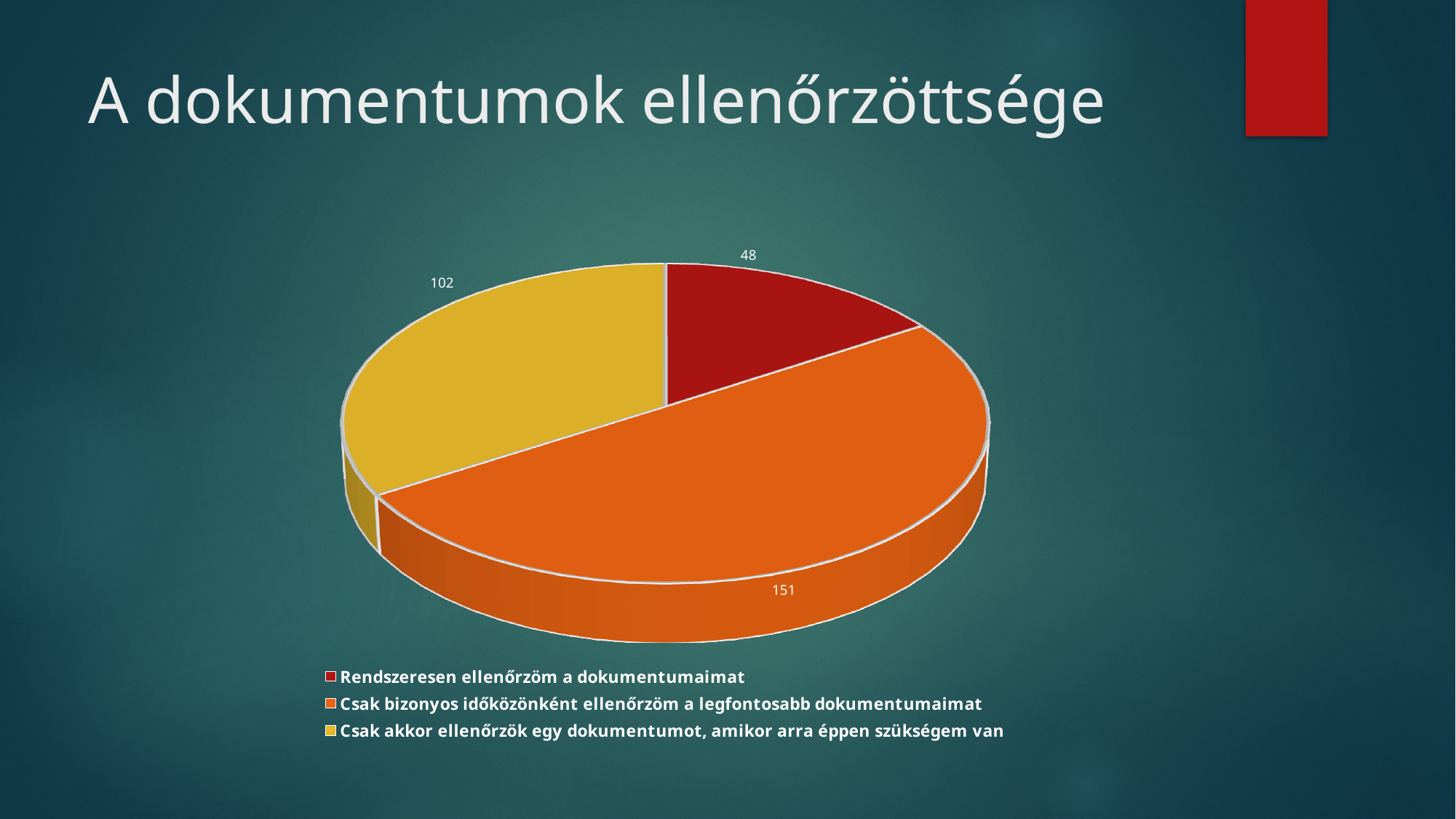
Which category has the smallest slice of the pie? Rendszeresen ellenőrzöm a dokumentumaimat What is the value for "Csak akkor ellenőrzök egy dokumentumot, amikor arra éppen szükségem van"? 102 What is the value for "Csak bizonyos időközönként ellenőrzöm a legfontosabb dokumentumaimat"? 151 What is the value for "Rendszeresen ellenőrzöm a dokumentumaimat"? 48 Which category has the largest slice of the pie? Csak bizonyos időközönként ellenőrzöm a legfontosabb dokumentumaimat What is the difference between the value for "Csak bizonyos időközönként ellenőrzöm a legfontosabb dokumentumaimat" and the value for "Csak akkor ellenőrzök egy dokumentumot, amikor arra éppen szükségem van"? 49 What kind of chart is shown on the slide? Pie chart How many slices does the pie chart have? 3 What is the title of the slide containing the pie chart? A dokumentumok ellenőrzöttsége Which is larger: the value for "Csak akkor ellenőrzök egy dokumentumot, amikor arra éppen szükségem van" or the value for "Rendszeresen ellenőrzöm a dokumentumaimat"? Csak akkor ellenőrzök egy dokumentumot, amikor arra éppen szükségem van What is the difference between the value for "Csak akkor ellenőrzök egy dokumentumot, amikor arra éppen szükségem van" and the value for "Rendszeresen ellenőrzöm a dokumentumaimat"? 54 What is the total of all the slices in the pie chart? 301